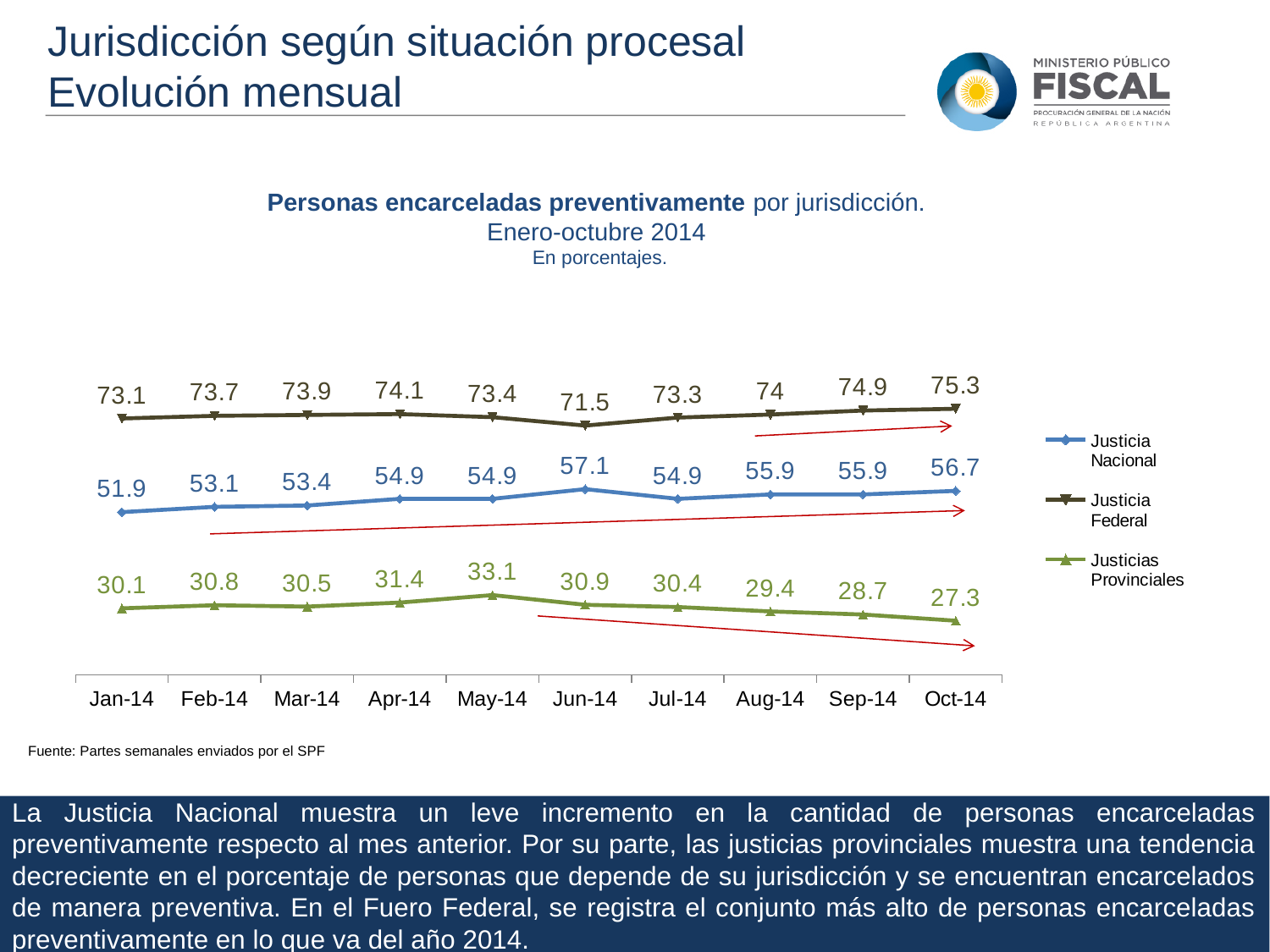
In which month does Justicia Federal reach its lowest value? Jun-14 Which is larger in Aug-14: Justicia Nacional or Justicias Provinciales? Justicia Nacional What is the value for Justicia Federal in Oct-14? 75.3 How many months are plotted along the x axis? 10 What type of chart is shown on the slide? line chart What is the value for Justicia Nacional in Jun-14? 57.1 Do the Justicias Provinciales values rise or fall from May-14 to Oct-14? fall What is the difference between the Justicia Nacional values in Oct-14 and Jan-14? 4.8 In which month does Justicias Provinciales reach its highest value? May-14 What is the value for Justicias Provinciales in May-14? 33.1 How many series does the legend list? 3 Which series is drawn in green? Justicias Provinciales